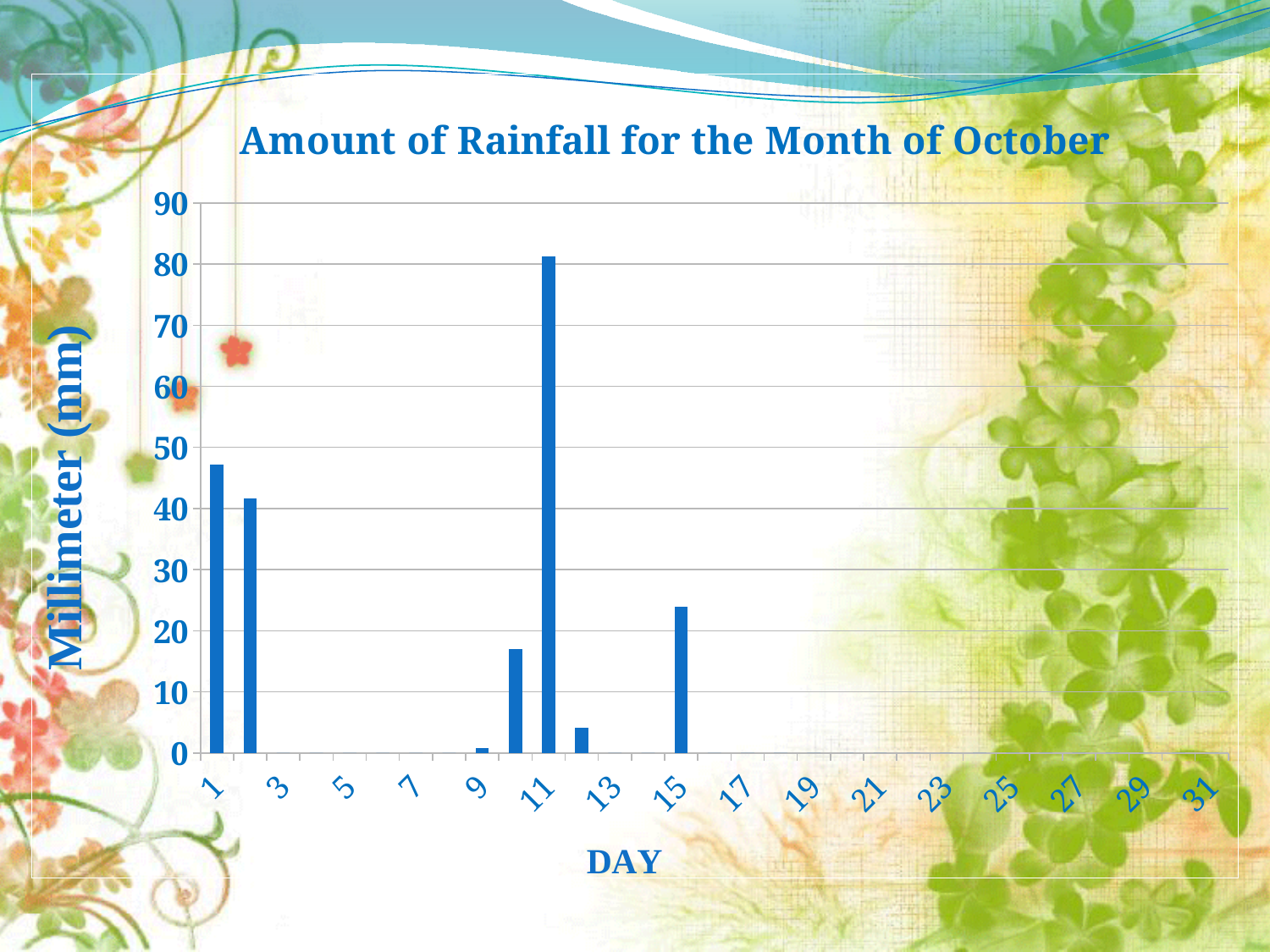
Is the rainfall value for day 10 greater or less than 20? less What kind of chart is shown on the slide? bar chart Which day has more rainfall, day 1 or day 2? day 1 What is the title of the chart? Amount of Rainfall for the Month of October Is the rainfall value for day 1 greater or less than 40? greater Is the rainfall value for day 15 greater or less than 30? less Which day has more rainfall, day 15 or day 10? day 15 Which day has the highest amount of rainfall? 11 How many days in the chart show a rainfall bar above zero? 7 What is the label on the vertical axis of the chart? Millimeter (mm)